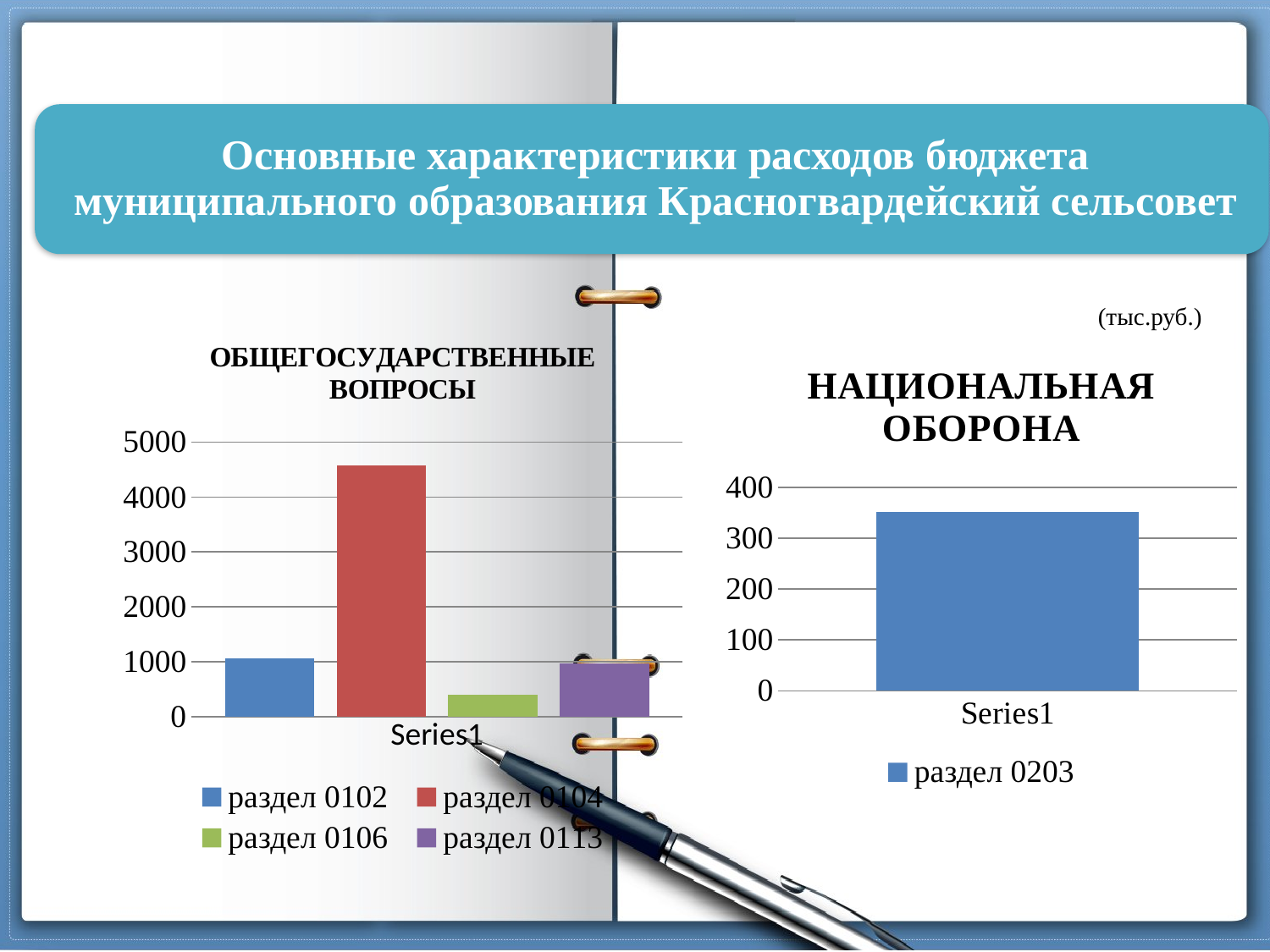
How many series does the legend of the "ОБЩЕГОСУДАРСТВЕННЫЕ ВОПРОСЫ" chart list? 4 In the "ОБЩЕГОСУДАРСТВЕННЫЕ ВОПРОСЫ" chart, which series has the lowest value? раздел 0106 In the "ОБЩЕГОСУДАРСТВЕННЫЕ ВОПРОСЫ" chart, is the value for раздел 0104 greater or less than 4000? greater In the "НАЦИОНАЛЬНАЯ ОБОРОНА" chart, is the value for раздел 0203 greater or less than 300? greater In the "НАЦИОНАЛЬНАЯ ОБОРОНА" chart, is the value for раздел 0203 greater or less than 400? less In the "ОБЩЕГОСУДАРСТВЕННЫЕ ВОПРОСЫ" chart, which is larger: раздел 0104 or раздел 0102? раздел 0104 In the "ОБЩЕГОСУДАРСТВЕННЫЕ ВОПРОСЫ" chart, what colour is the bar for раздел 0104? red How many series does the legend of the "НАЦИОНАЛЬНАЯ ОБОРОНА" chart list? 1 What kind of chart is the "ОБЩЕГОСУДАРСТВЕННЫЕ ВОПРОСЫ" chart? bar chart In the "ОБЩЕГОСУДАРСТВЕННЫЕ ВОПРОСЫ" chart, which series has the highest value? раздел 0104